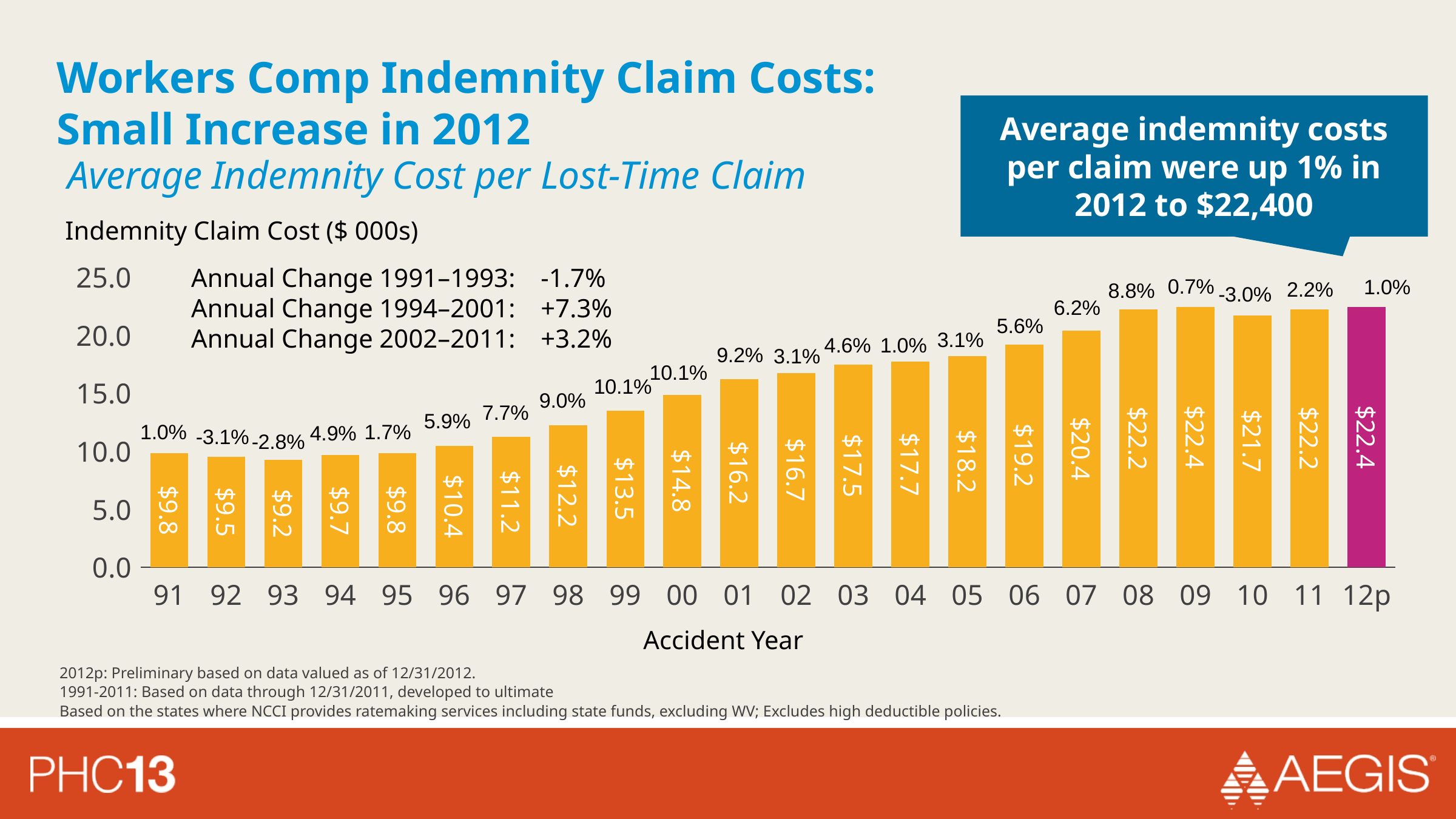
What is the indemnity claim cost for accident year 93? $9.2 What kind of chart is shown on the slide? bar chart What is the difference between the indemnity claim cost for 08 and for 10? $0.5 Which has a higher indemnity claim cost, accident year 01 or accident year 05? 05 What is the difference between the indemnity claim cost for 12p and for 91? $12.6 Is the indemnity claim cost for accident year 00 greater or less than 10.0? greater Do the indemnity claim costs generally rise or fall from 91 to 12p? rise What is the indemnity claim cost for accident year 12p? $22.4 Which accident year has the lowest indemnity claim cost? 93 What is the indemnity claim cost for accident year 07? $20.4 How many accident years are shown on the x axis? 22 What annual percentage change is shown above the bar for accident year 99? 10.1%